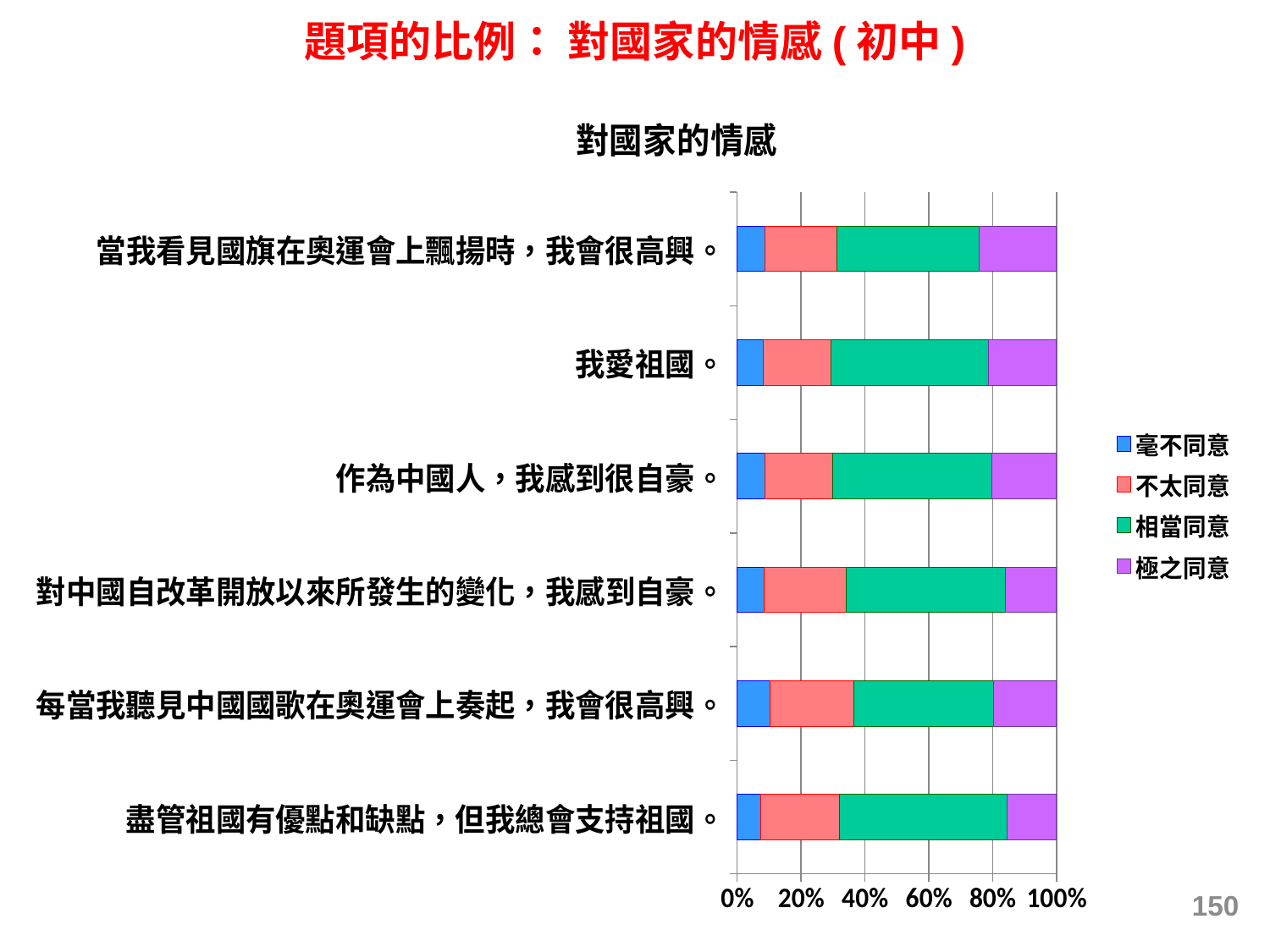
For the statement 作為中國人，我感到很自豪。, which is larger: the 相當同意 share or the 極之同意 share? 相當同意 For the statement 每當我聽見中國國歌在奧運會上奏起，我會很高興。, which is larger: the 不太同意 share or the 毫不同意 share? 不太同意 Which legend entry is shown in purple? 極之同意 Which response category has the largest share for the statement 我愛祖國。? 相當同意 Which response category has the smallest share for the statement 盡管祖國有優點和缺點，但我總會支持祖國。? 毫不同意 How many series does the legend list? 4 What kind of chart is shown on the slide? stacked bar chart Is the 極之同意 share for 對中國自改革開放以來所發生的變化，我感到自豪。 greater or less than 20%? less Is the 相當同意 share for 我愛祖國。 greater or less than 40%? greater How many statements (categories) are plotted in the chart? 6 Is the 毫不同意 share for 當我看見國旗在奧運會上飄揚時，我會很高興。 greater or less than 20%? less What is the title of the chart? 對國家的情感